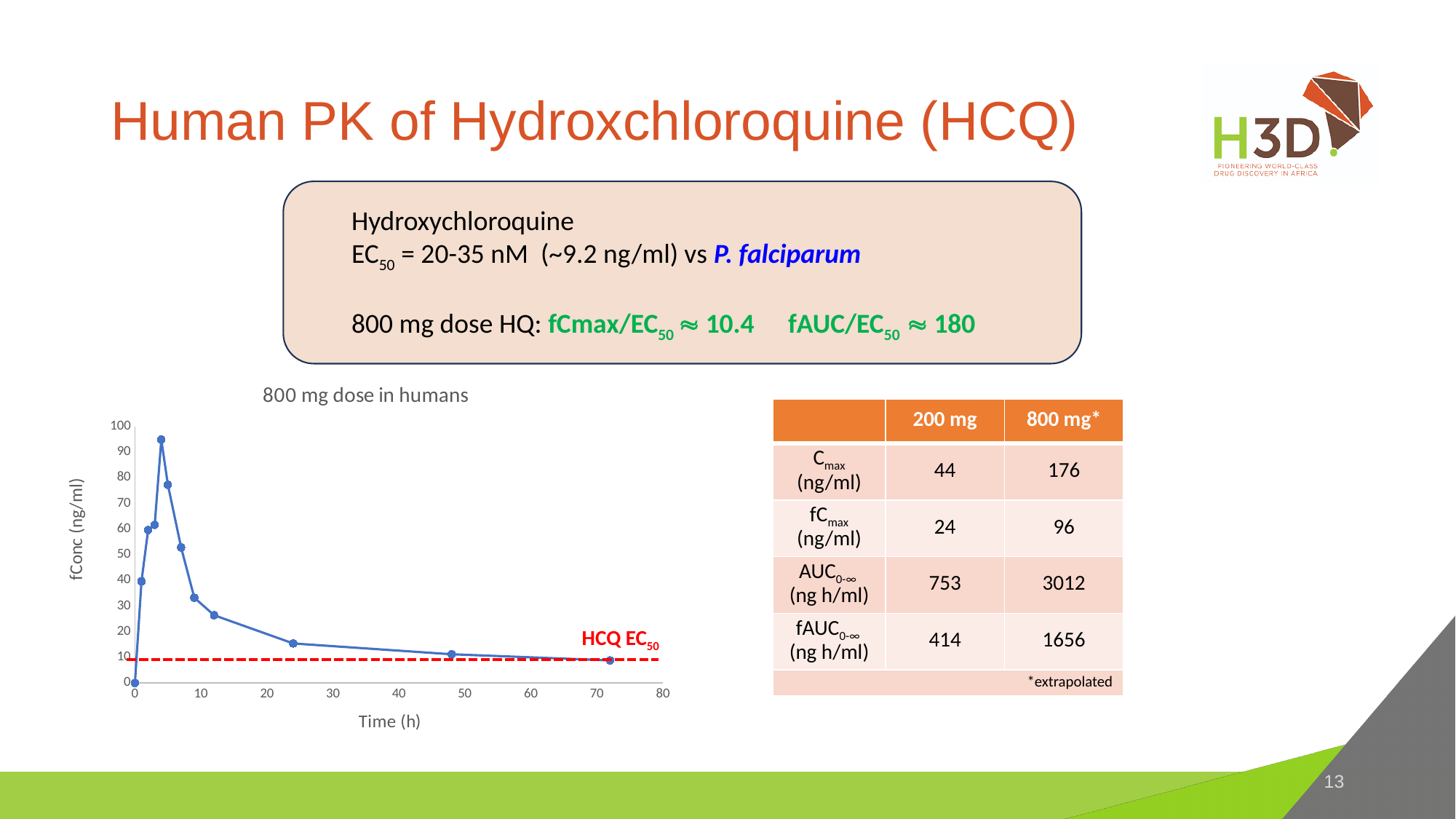
Which is larger on the chart: the fConc value at 5 h or at 7 h? 5 h Is the fConc value at 12 h greater or less than 20 ng/ml? greater Is the fConc value at 48 h greater or less than 20 ng/ml? less Does the fConc value rise or fall between 10 h and 80 h on the chart? fall What is the title of the chart on the left of the slide? 800 mg dose in humans Is the fConc value at 1 h greater or less than 30 ng/ml? greater What label is given to the red dashed horizontal line on the chart? HCQ EC50 Which is larger on the chart: the fConc value at 12 h or at 48 h? 12 h What kind of chart is shown under the heading '800 mg dose in humans'? line chart